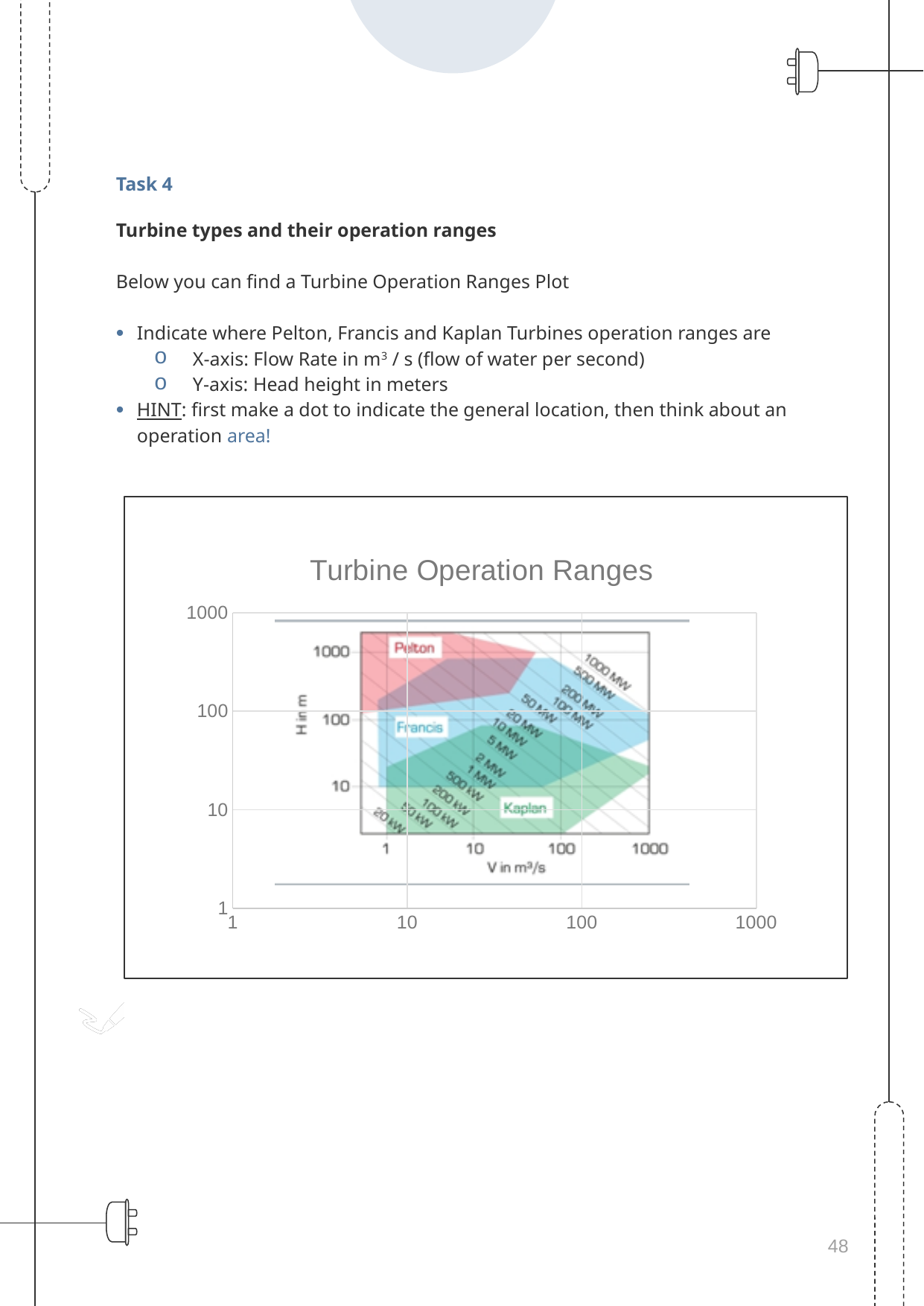
How many turbine types are labelled in the Turbine Operation Ranges chart? 3 In the Turbine Operation Ranges chart, which operates at a higher flow rate, Kaplan or Pelton? Kaplan Which turbine type's operation range sits at the highest head height in the Turbine Operation Ranges chart? Pelton In the Turbine Operation Ranges chart, is the head height of the Kaplan region greater or less than 100? less In the Turbine Operation Ranges chart, which operates at a higher head height, Pelton or Kaplan? Pelton In the Turbine Operation Ranges chart, is the head height of the Pelton region greater or less than 100? greater Which turbine type's operation range sits at the lowest head height in the Turbine Operation Ranges chart? Kaplan What is the title of the chart on the slide? Turbine Operation Ranges What is the highest value shown on the x axis of the Turbine Operation Ranges chart? 1000